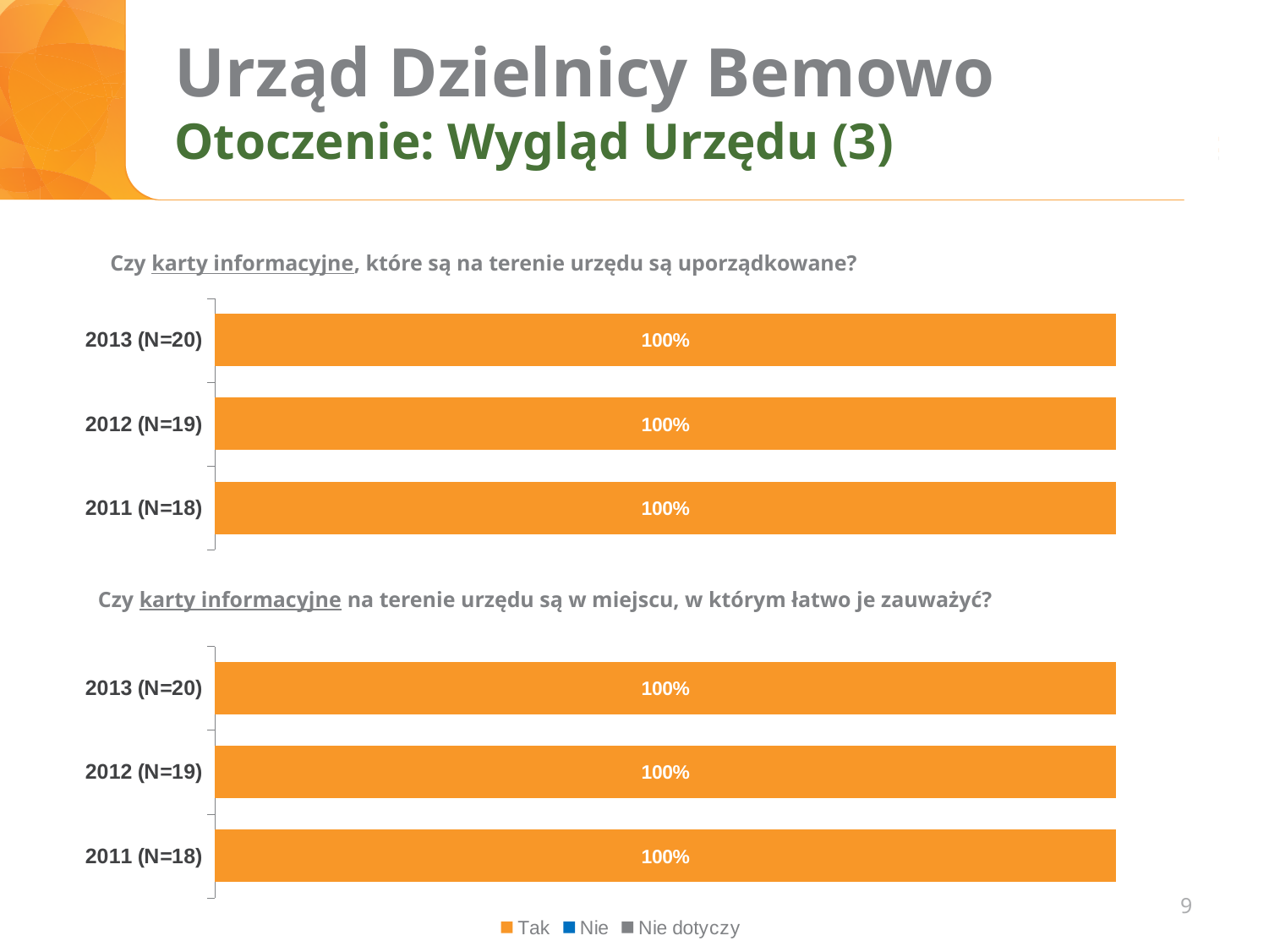
In the top chart, what is the difference between the values for 2013 (N=20) and 2011 (N=18)? 0% In the top chart ("Czy karty informacyjne, które są na terenie urzędu są uporządkowane?"), what is the value for 2011 (N=18)? 100% What kind of chart is the top chart? Bar chart How many categories (years) are shown in the top chart? 3 In the bottom chart ("Czy karty informacyjne na terenie urzędu są w miejscu, w którym łatwo je zauważyć?"), what is the value for 2013 (N=20)? 100% In the bottom chart, what is the difference between the values for 2012 (N=19) and 2011 (N=18)? 0% In the bottom chart ("Czy karty informacyjne na terenie urzędu są w miejscu, w którym łatwo je zauważyć?"), what is the value for 2012 (N=19)? 100% How many categories (years) are shown in the bottom chart? 3 Which series does the orange colour represent in the legend? Tak What kind of chart is the bottom chart? Bar chart How many series does the legend at the bottom of the slide list? 3 In the top chart ("Czy karty informacyjne, które są na terenie urzędu są uporządkowane?"), what is the value for 2013 (N=20)? 100%